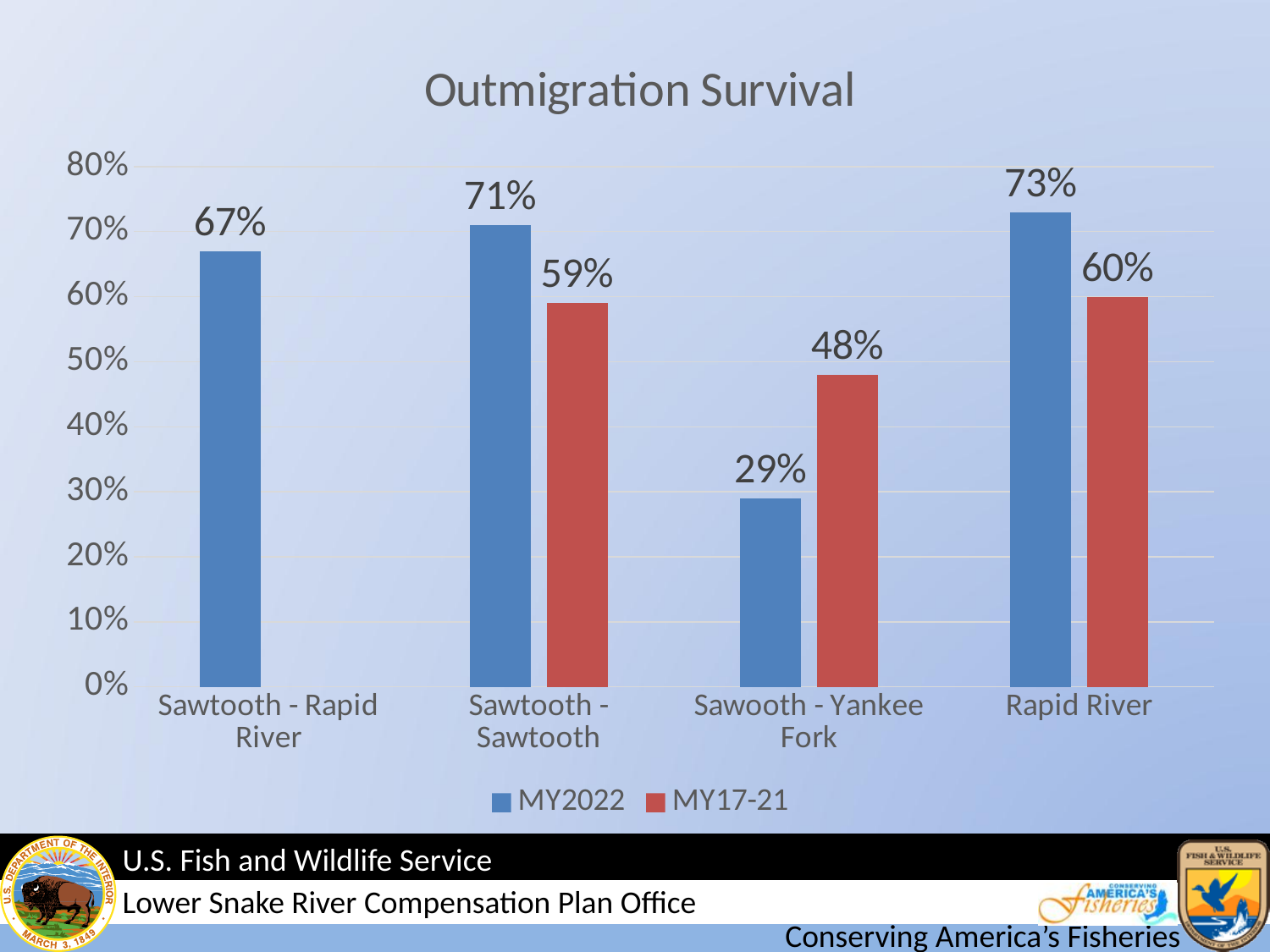
What is the MY17-21 value for Sawooth - Yankee Fork? 48% For Sawooth - Yankee Fork, which series has the larger value, MY2022 or MY17-21? MY17-21 Which category has the highest MY2022 value? Rapid River What is the title of the chart? Outmigration Survival Is the MY17-21 value for Rapid River greater or less than 50%? greater What is the difference between the MY2022 and MY17-21 values for Sawtooth - Sawtooth? 12% How many series does the legend list? 2 How many categories are shown on the x axis? 4 Which category has the lowest MY2022 value? Sawooth - Yankee Fork What kind of chart is shown on the slide? bar chart What is the MY2022 outmigration survival value for Sawtooth - Rapid River? 67% What is the MY2022 value for Rapid River? 73%